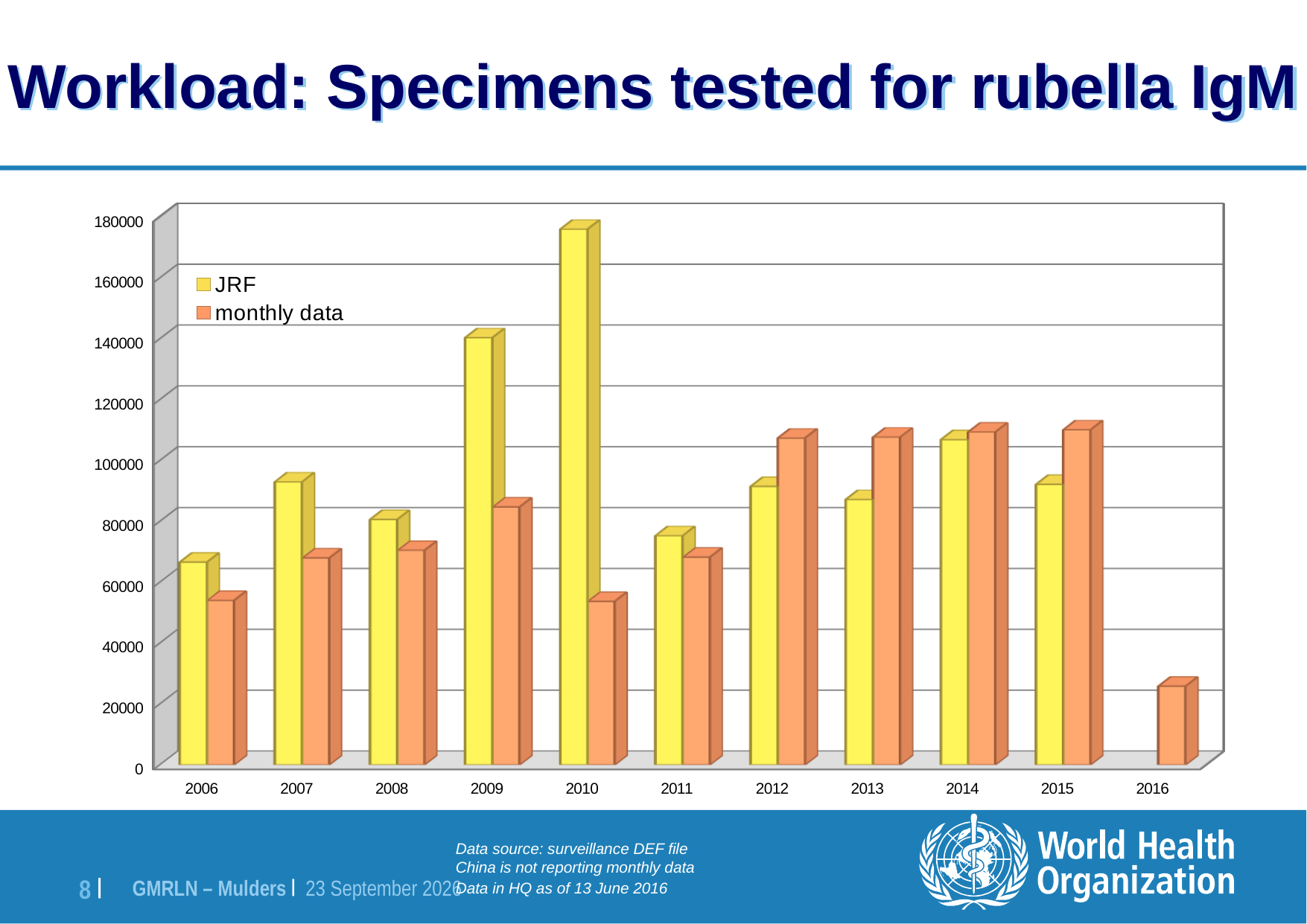
How many series does the legend list? 2 Is the JRF value for 2009 greater or less than 120000? greater Is the JRF value for 2010 greater or less than 160000? greater Which year has the highest JRF value? 2010 Which year has the lowest JRF value? 2006 How many years are shown on the x axis? 11 Is the monthly data value for 2016 greater or less than 40000? less In 2009, which is larger: the JRF value or the monthly data value? JRF What kind of chart is shown on the slide? bar chart Which year has the lowest monthly data value? 2016 Which year has a monthly data bar but no JRF bar? 2016 In 2012, which is larger: the JRF value or the monthly data value? monthly data